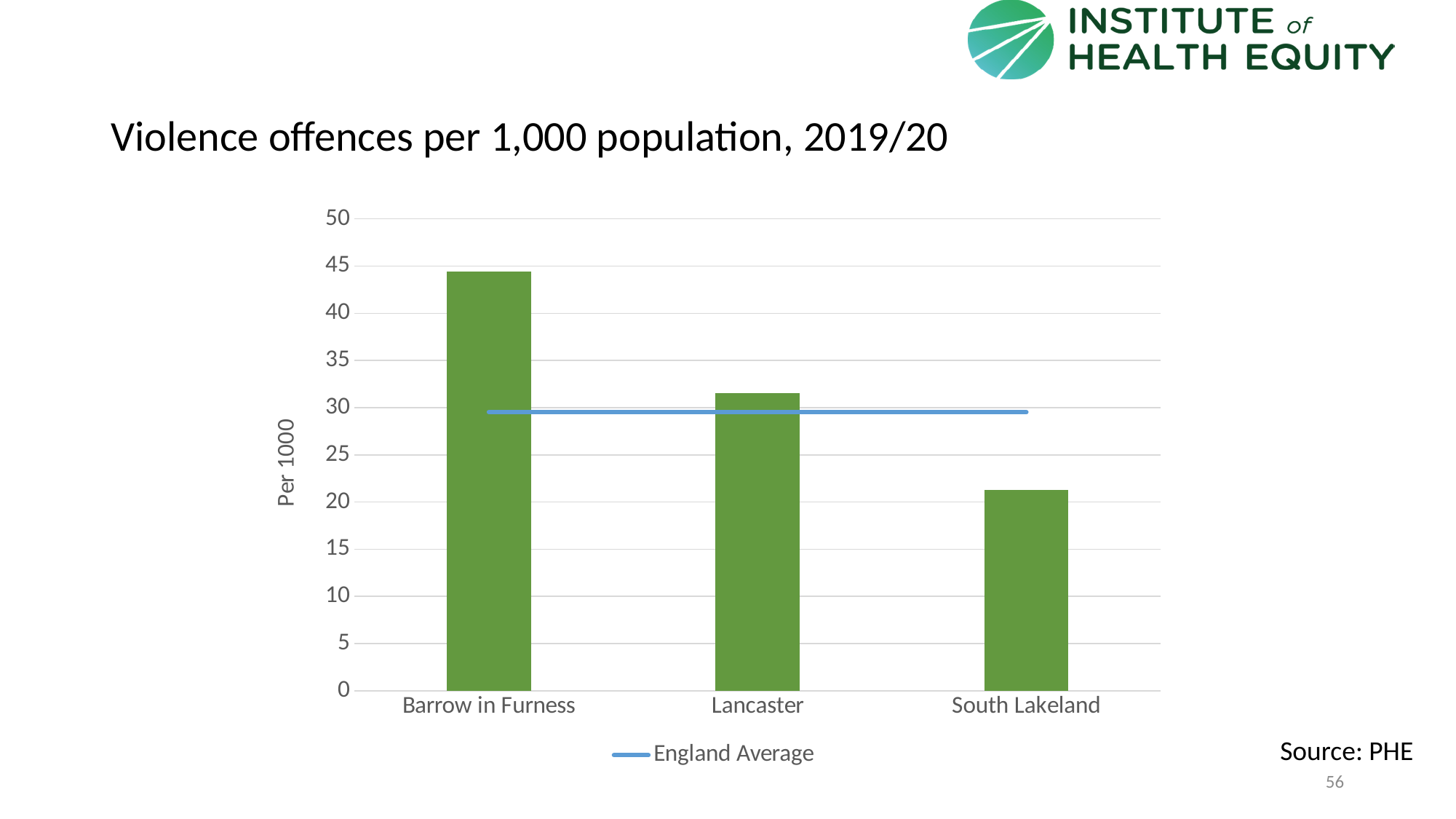
Is the value for Lancaster greater or less than 30? greater What kind of chart is shown on the slide? Bar chart What does the blue horizontal line in the chart represent, according to the legend? England Average How many local areas are shown on the x axis of the chart? 3 Is the value for South Lakeland greater or less than 25? less What is the title of the chart? Violence offences per 1,000 population, 2019/20 Which has the higher rate of violence offences, Lancaster or South Lakeland? Lancaster Which area has the highest rate of violence offences per 1,000 population? Barrow in Furness Do the bar values rise or fall from left to right across the x axis? fall Is the value for Barrow in Furness greater or less than 40? greater Which area has the lowest rate of violence offences per 1,000 population? South Lakeland